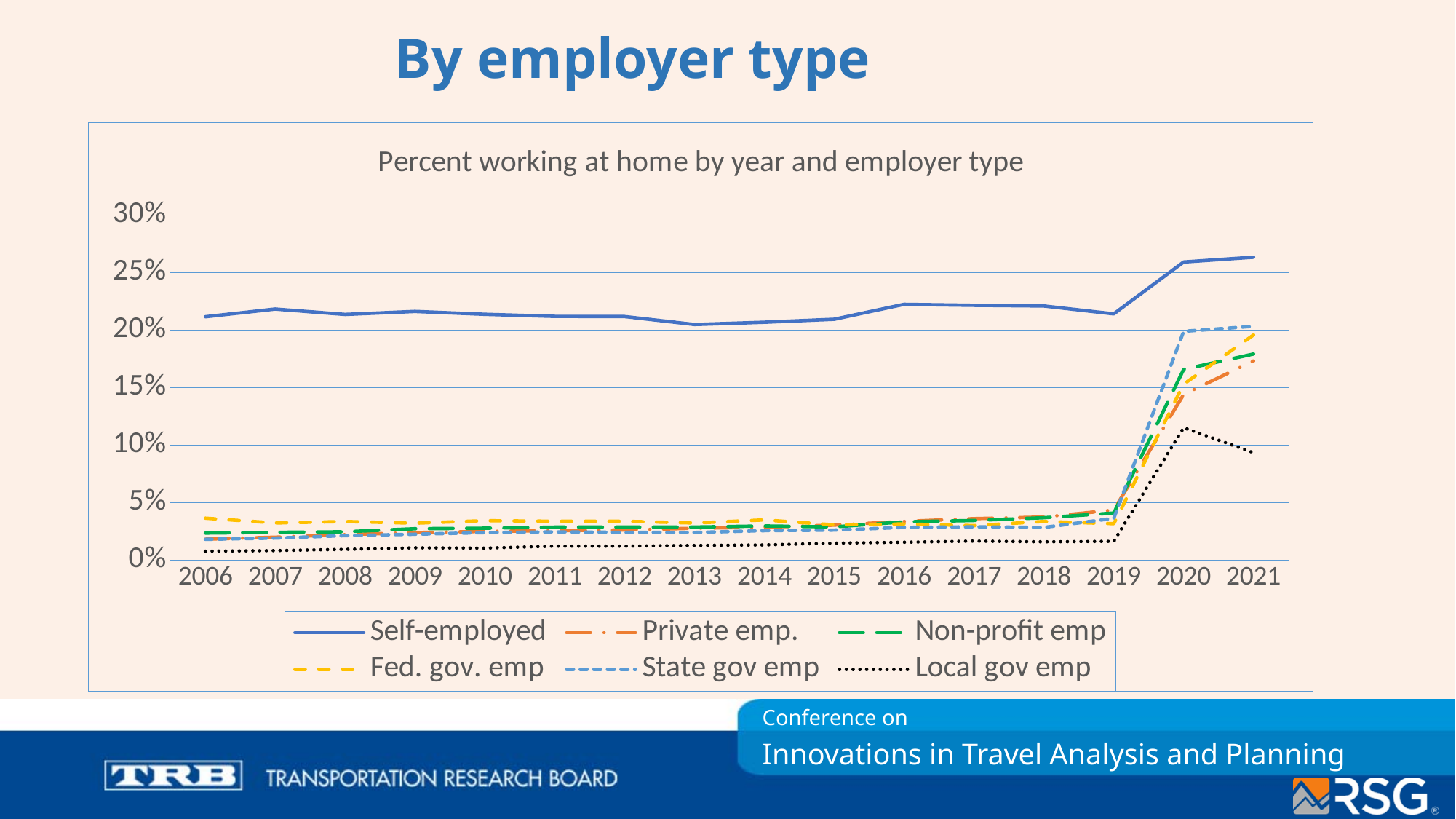
How many years are shown on the x axis? 16 In 2021, which is larger: State gov emp or Local gov emp? State gov emp Is the value for State gov emp in 2020 greater or less than 15%? greater What kind of chart is shown on the slide? line chart Is the value for Self-employed in 2020 greater or less than 25%? greater Which employer type has the highest percent working at home in 2021? Self-employed Which employer type has the lowest percent working at home in 2021? Local gov emp How many series does the legend list? 6 What is the title of the chart? Percent working at home by year and employer type Does the Self-employed line rise or fall from 2019 to 2020? rise Is the value for Self-employed in 2006 greater or less than 20%? greater